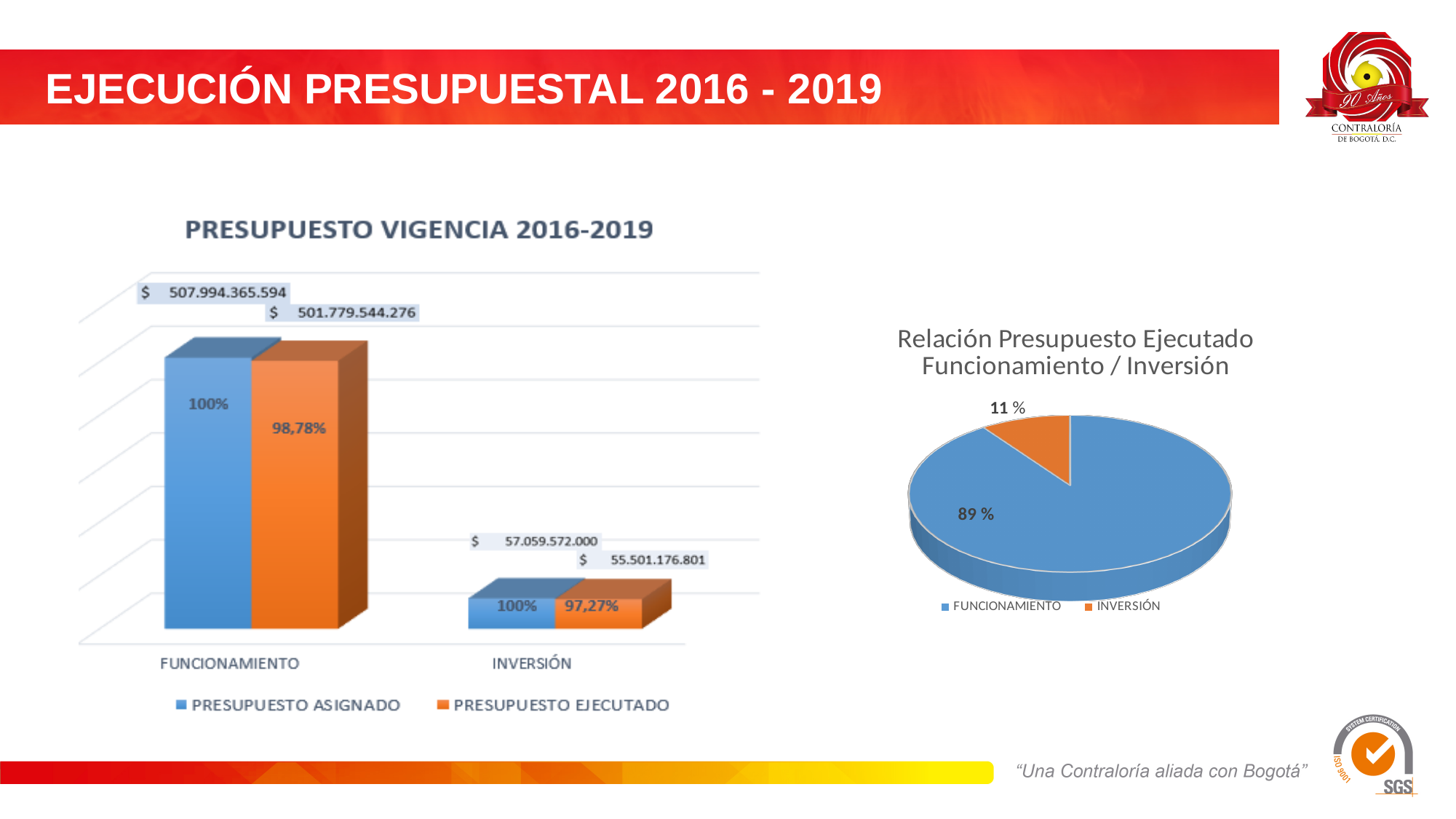
In the chart titled PRESUPUESTO VIGENCIA 2016-2019, what is the difference between PRESUPUESTO ASIGNADO and PRESUPUESTO EJECUTADO for FUNCIONAMIENTO? $ 6.214.821.318 In the pie chart titled Relación Presupuesto Ejecutado Funcionamiento / Inversión, which slice is the largest? FUNCIONAMIENTO In the chart titled PRESUPUESTO VIGENCIA 2016-2019, what is the PRESUPUESTO EJECUTADO value for INVERSIÓN? $ 55.501.176.801 What kind of chart is the chart titled PRESUPUESTO VIGENCIA 2016-2019? Bar chart In the chart titled PRESUPUESTO VIGENCIA 2016-2019, how many series does the legend list? 2 In the pie chart titled Relación Presupuesto Ejecutado Funcionamiento / Inversión, what share does INVERSIÓN have? 11 % In the chart titled PRESUPUESTO VIGENCIA 2016-2019, what execution percentage is shown on the PRESUPUESTO EJECUTADO bar for INVERSIÓN? 97,27% In the chart titled PRESUPUESTO VIGENCIA 2016-2019, what is the PRESUPUESTO ASIGNADO value for INVERSIÓN? $ 57.059.572.000 In the chart titled PRESUPUESTO VIGENCIA 2016-2019, what is the PRESUPUESTO EJECUTADO value for FUNCIONAMIENTO? $ 501.779.544.276 In the chart titled PRESUPUESTO VIGENCIA 2016-2019, what execution percentage is shown on the PRESUPUESTO EJECUTADO bar for FUNCIONAMIENTO? 98,78% In the chart titled PRESUPUESTO VIGENCIA 2016-2019, which category has the larger PRESUPUESTO ASIGNADO, FUNCIONAMIENTO or INVERSIÓN? FUNCIONAMIENTO In the chart titled PRESUPUESTO VIGENCIA 2016-2019, what is the PRESUPUESTO ASIGNADO value for FUNCIONAMIENTO? $ 507.994.365.594